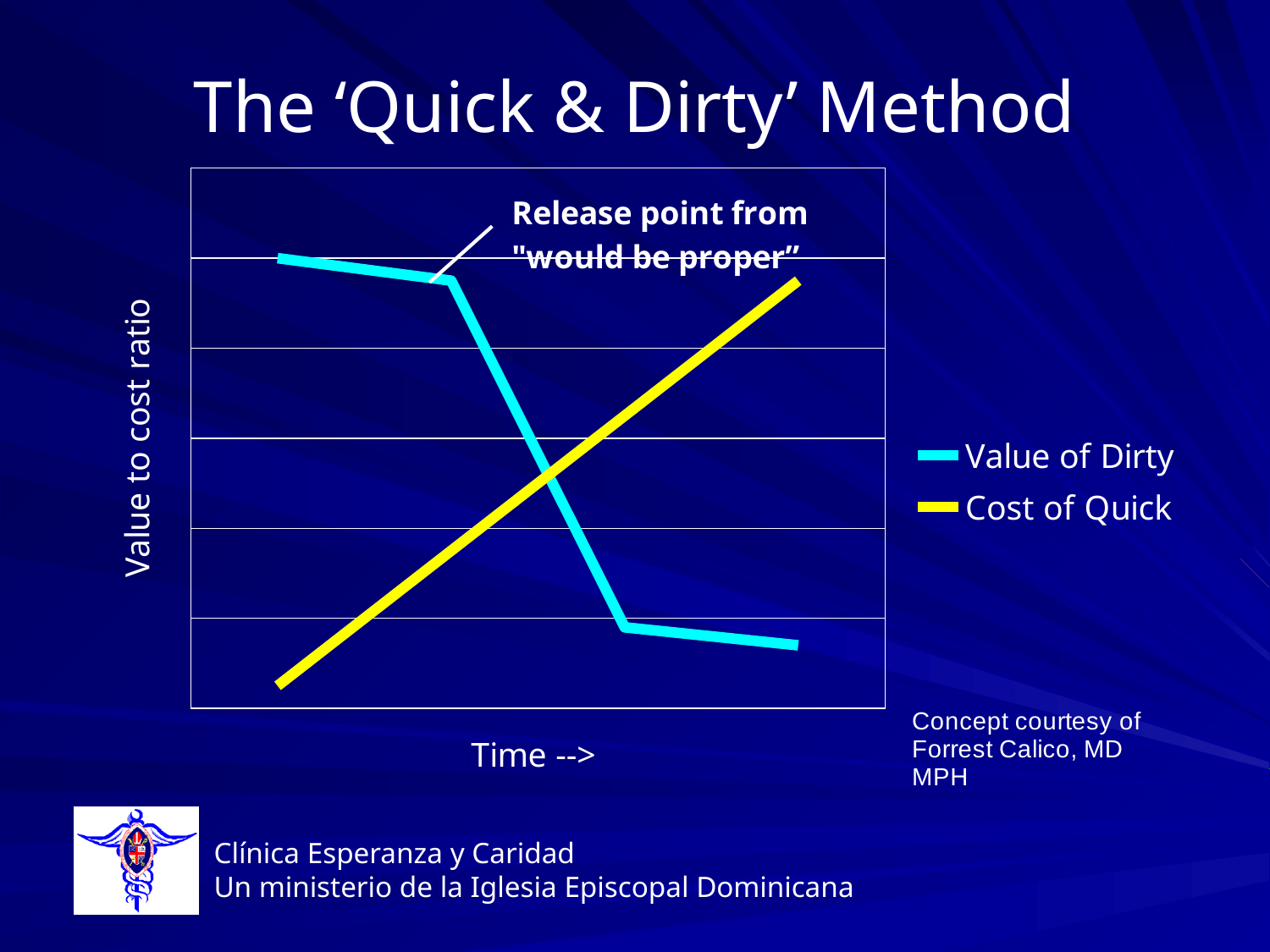
What is the title of the slide containing the chart? The 'Quick & Dirty' Method How many series does the legend list? 2 What kind of chart is shown on the slide? Line chart At the right (end) of the time axis, which series is higher: 'Value of Dirty' or 'Cost of Quick'? Cost of Quick What is the label on the vertical axis of the chart? Value to cost ratio At the left (start) of the time axis, which series is higher: 'Value of Dirty' or 'Cost of Quick'? Value of Dirty Does the 'Cost of Quick' line rise or fall as time increases along the x axis? Rises Does the 'Value of Dirty' line rise or fall as time increases along the x axis? Falls